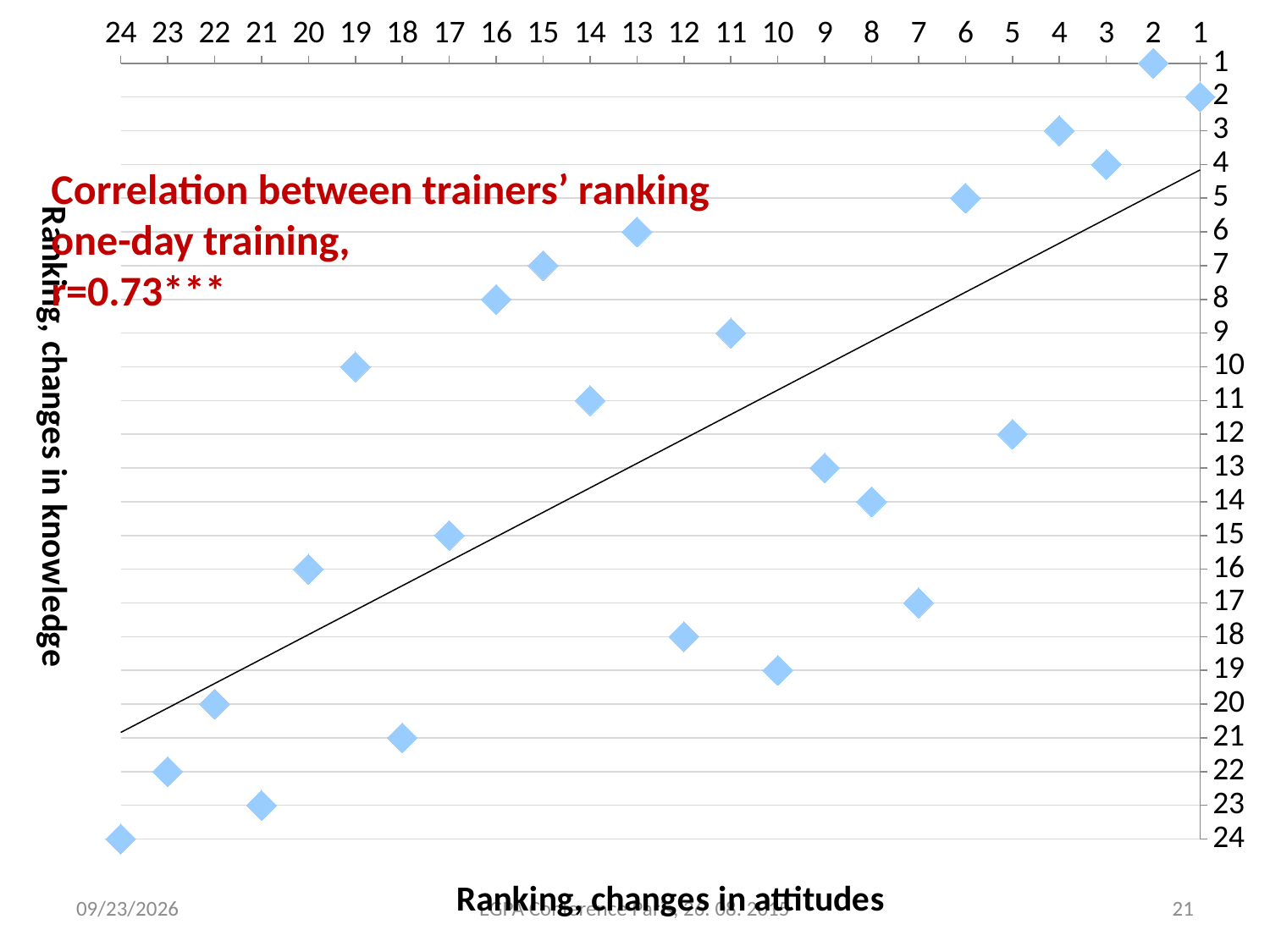
Which has the higher knowledge ranking number: the point with attitude ranking 12 or the point with attitude ranking 11? Attitude ranking 12 What is the ranking for changes in knowledge for the point with attitude ranking 2? 1 What is the title of the horizontal axis? Ranking, changes in attitudes Which point has the lowest (best) ranking in changes in knowledge, by its attitude ranking? Attitude ranking 2 What is the ranking for changes in knowledge for the point with attitude ranking 13? 6 What kind of chart is shown on the slide? Scatter plot What is the ranking for changes in knowledge for the point with attitude ranking 24? 24 What correlation coefficient is stated in the chart title? r=0.73*** What is the ranking for changes in knowledge for the point with attitude ranking 7? 17 What is the difference in knowledge ranking between the points with attitude ranking 10 and attitude ranking 6? 14 What is the ranking for changes in knowledge for the point with attitude ranking 19? 10 How many data points are plotted in the scatter chart? 24